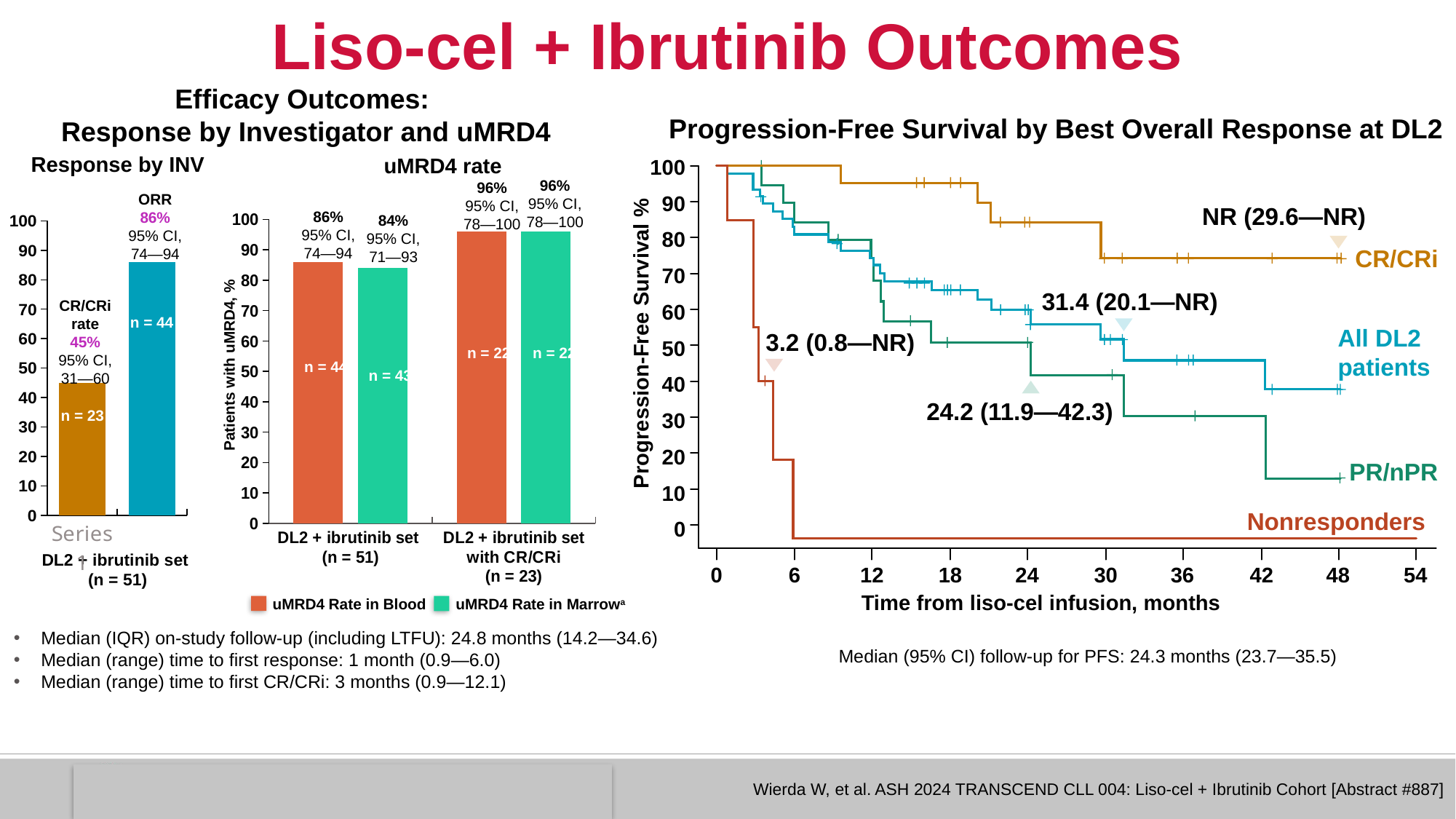
In the Progression-Free Survival chart, how many patient groups are plotted as curves? 4 In the uMRD4 rate chart, how many series does the legend list? 2 In the uMRD4 rate chart, which is larger for the DL2 + ibrutinib set (n = 51): the uMRD4 rate in blood or in marrow? uMRD4 Rate in Blood In the Response by INV chart, how many patients (n) does the ORR bar represent? n = 44 In the uMRD4 rate chart, what is the uMRD4 rate in marrow for the DL2 + ibrutinib set (n = 51)? 84% In the Response by INV chart, what is the CR/CRi rate? 45% In the Progression-Free Survival chart, what is the median PFS (95% CI) for Nonresponders? 3.2 (0.8—NR) In the Progression-Free Survival chart, what is the median PFS (95% CI) for PR/nPR patients? 24.2 (11.9—42.3) What kind of chart is the uMRD4 rate chart? Bar chart In the Response by INV chart, what is the ORR? 86% In the Response by INV chart, what is the difference in percentage points between the ORR and the CR/CRi rate? 41 In the uMRD4 rate chart, what is the uMRD4 rate in blood for the DL2 + ibrutinib set with CR/CRi (n = 23)? 96%